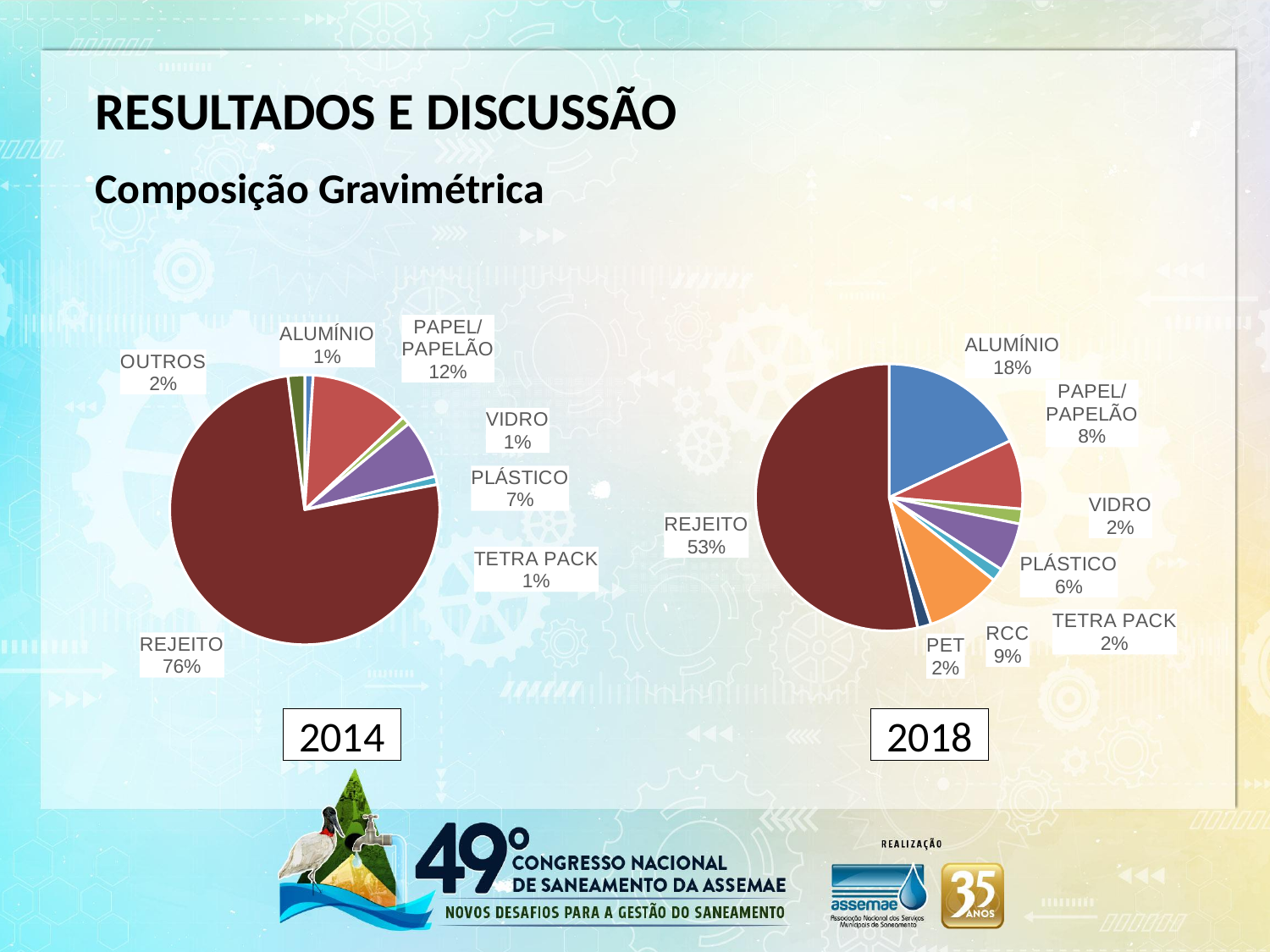
How many categories are shown in the 2018 pie chart? 8 In the 2018 pie chart, which category has the largest share? REJEITO In the 2014 pie chart, what is the value for PAPEL/PAPELÃO? 12% In the 2018 pie chart, what share does ALUMÍNIO have? 18% What is the difference between the REJEITO share in 2014 and in 2018? 23% How many categories are shown in the 2014 pie chart? 7 In the 2014 pie chart, what share does REJEITO have? 76% What type of chart is used for the 2014 data? Pie chart In the 2018 pie chart, which is larger, PLÁSTICO or PAPEL/PAPELÃO? PAPEL/PAPELÃO In the 2014 pie chart, what is the difference between PAPEL/PAPELÃO and PLÁSTICO? 5% In the 2014 pie chart, which category has the largest share? REJEITO In the 2018 pie chart, what is the value for RCC? 9%